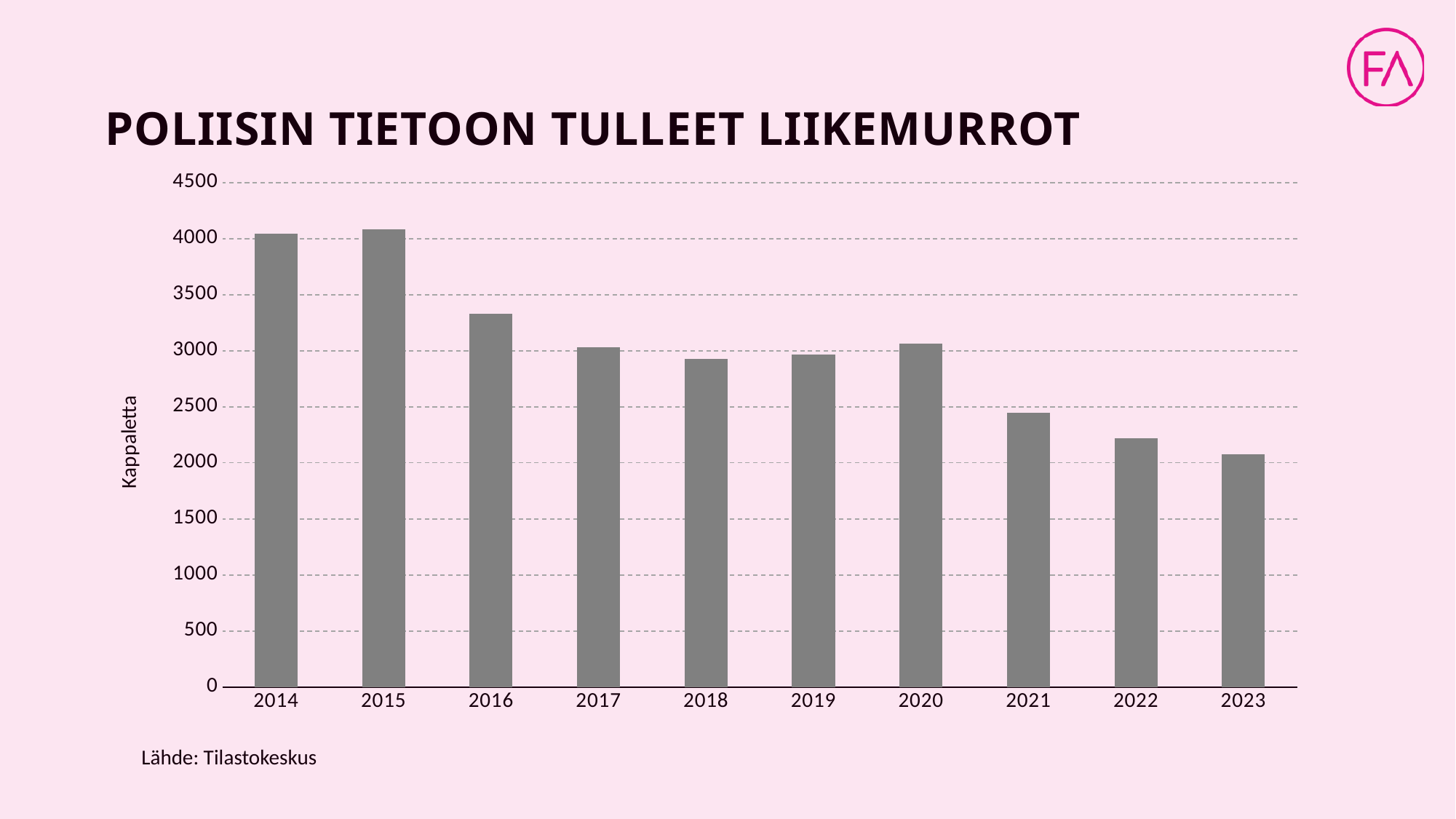
Which is larger, the value for 2016 or the value for 2017? 2016 Is the value for 2023 greater or less than 2000? greater What kind of chart is shown on the slide? bar chart Is the value for 2021 greater or less than 2500? less Which year has the lowest value in the chart? 2023 Is the value for 2022 greater or less than 2500? less Do the values generally rise or fall from 2014 to 2023? fall How many years are shown on the x axis of the chart? 10 What is the label on the y axis of the chart? Kappaletta What is the title of the chart? POLIISIN TIETOON TULLEET LIIKEMURROT Which is larger, the value for 2021 or the value for 2022? 2021